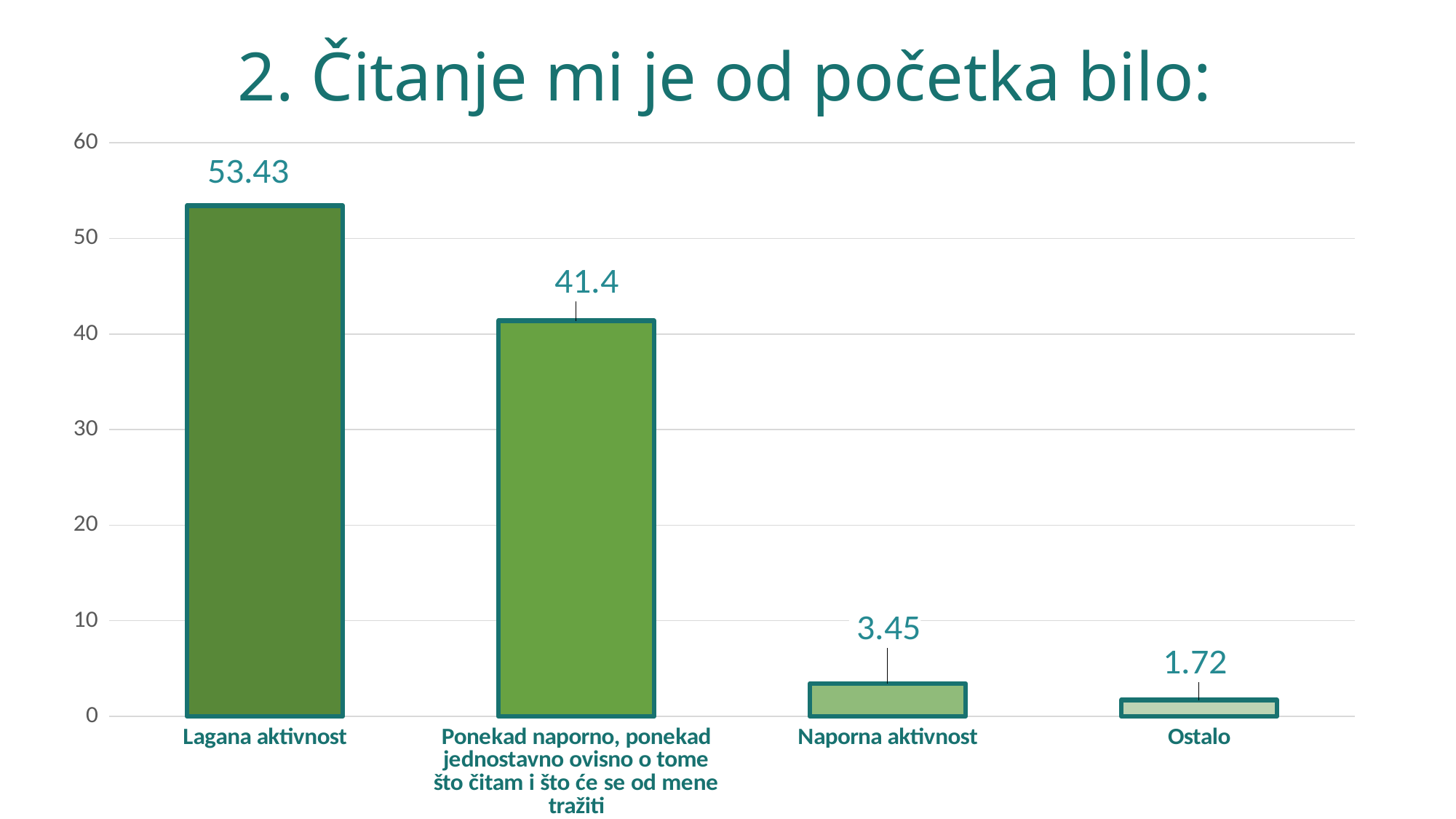
What is the value for Naporna aktivnost? 3.45 How many categories are shown in the chart? 4 Is the value for Lagana aktivnost greater or less than 50? greater Which is larger, the value for Lagana aktivnost or the value for Ponekad naporno, ponekad jednostavno? Lagana aktivnost What is the value for Lagana aktivnost? 53.43 Which category has the highest value? Lagana aktivnost What is the value for Ostalo? 1.72 What is the value for the category 'Ponekad naporno, ponekad jednostavno ovisno o tome što čitam i što će se od mene tražiti'? 41.4 What kind of chart is shown on the slide? Bar chart Which category has the lowest value? Ostalo What is the difference between the values for Lagana aktivnost and Naporna aktivnost? 49.98 What is the difference between the values for Naporna aktivnost and Ostalo? 1.73